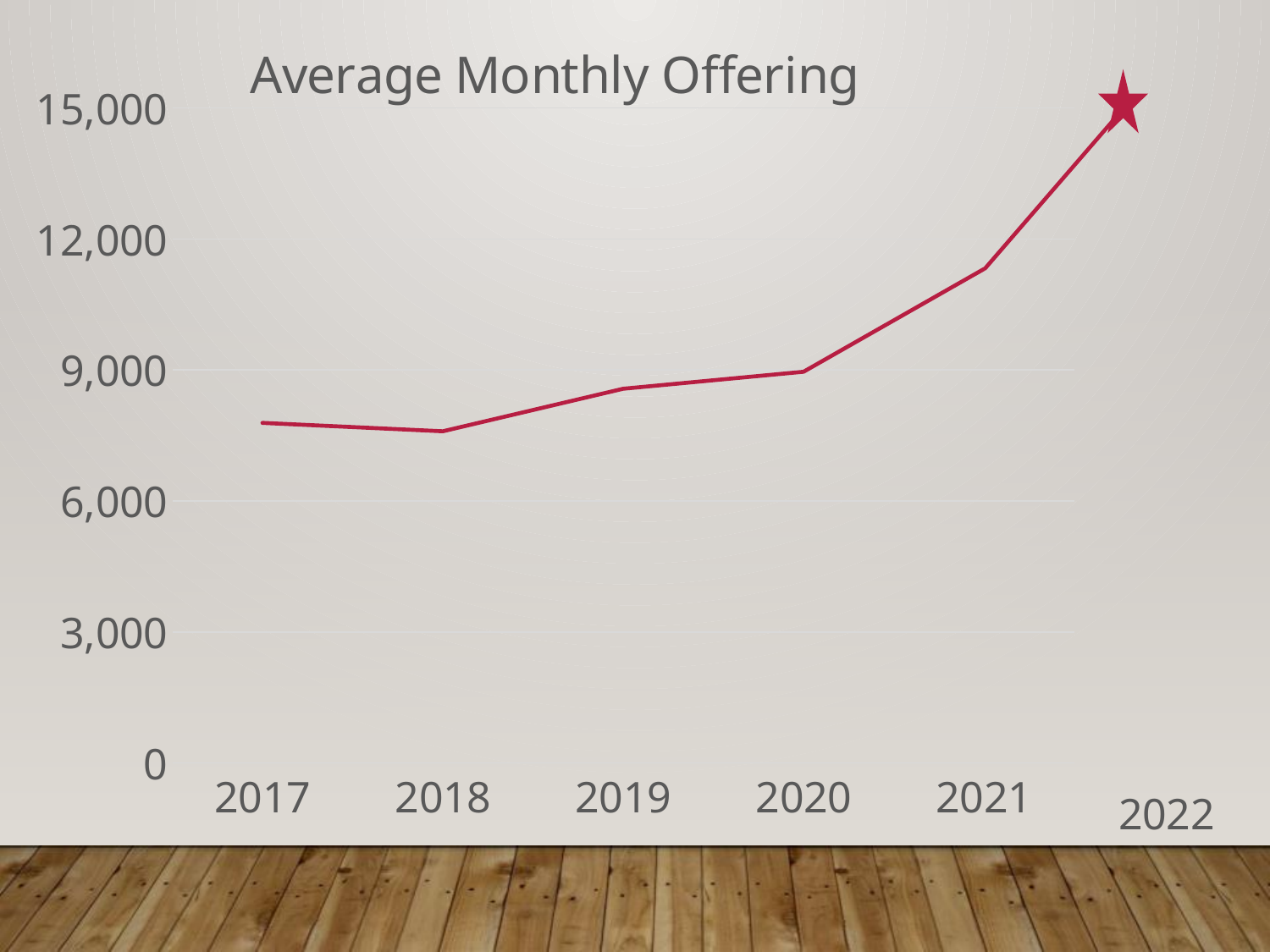
Do the values generally rise or fall from 2018 to 2022? rise Is the value for 2017 greater or less than 6,000? greater What kind of chart is shown on the slide? line chart Is the value for 2017 greater or less than 9,000? less Is the value for 2019 greater or less than 9,000? less How many years are plotted on the x axis? 6 Which is larger, the value for 2021 or the value for 2019? 2021 What is the title of the chart? Average Monthly Offering Which year has the highest average monthly offering? 2022